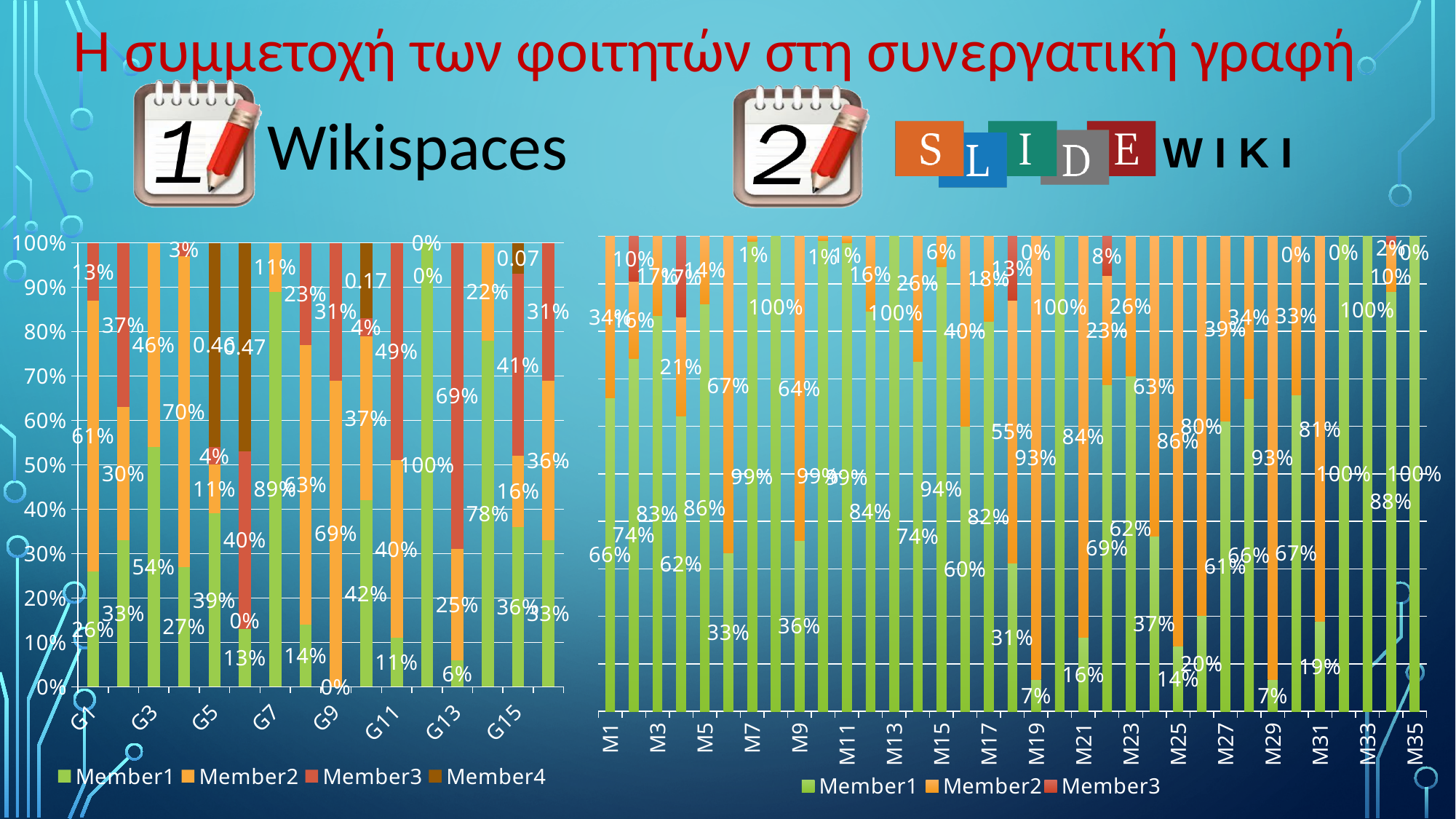
On the Wikispaces chart on the left, which is larger: the Member1 value for G7 or the Member1 value for G6? G7 On the SlideWiki chart on the right, what is the Member2 value for M6? 67% How many M categories are plotted on the SlideWiki chart on the right? 35 On the Wikispaces chart on the left, is the Member1 value for G3 greater or less than 50%? greater On the Wikispaces chart on the left, what is the difference between the Member2 value (61%) and the Member1 value (26%) for G1? 35% On the SlideWiki chart on the right, what is the Member1 value for M19? 7% How many series does the legend of the SlideWiki chart on the right list? 3 How many series does the legend of the Wikispaces chart on the left list? 4 How many groups (G categories) are plotted on the Wikispaces chart on the left? 16 On the Wikispaces chart on the left, what is the Member2 value for G1? 61% On the Wikispaces chart on the left, what is the Member1 value for G12? 100% What kind of chart is the Wikispaces chart on the left? stacked bar chart